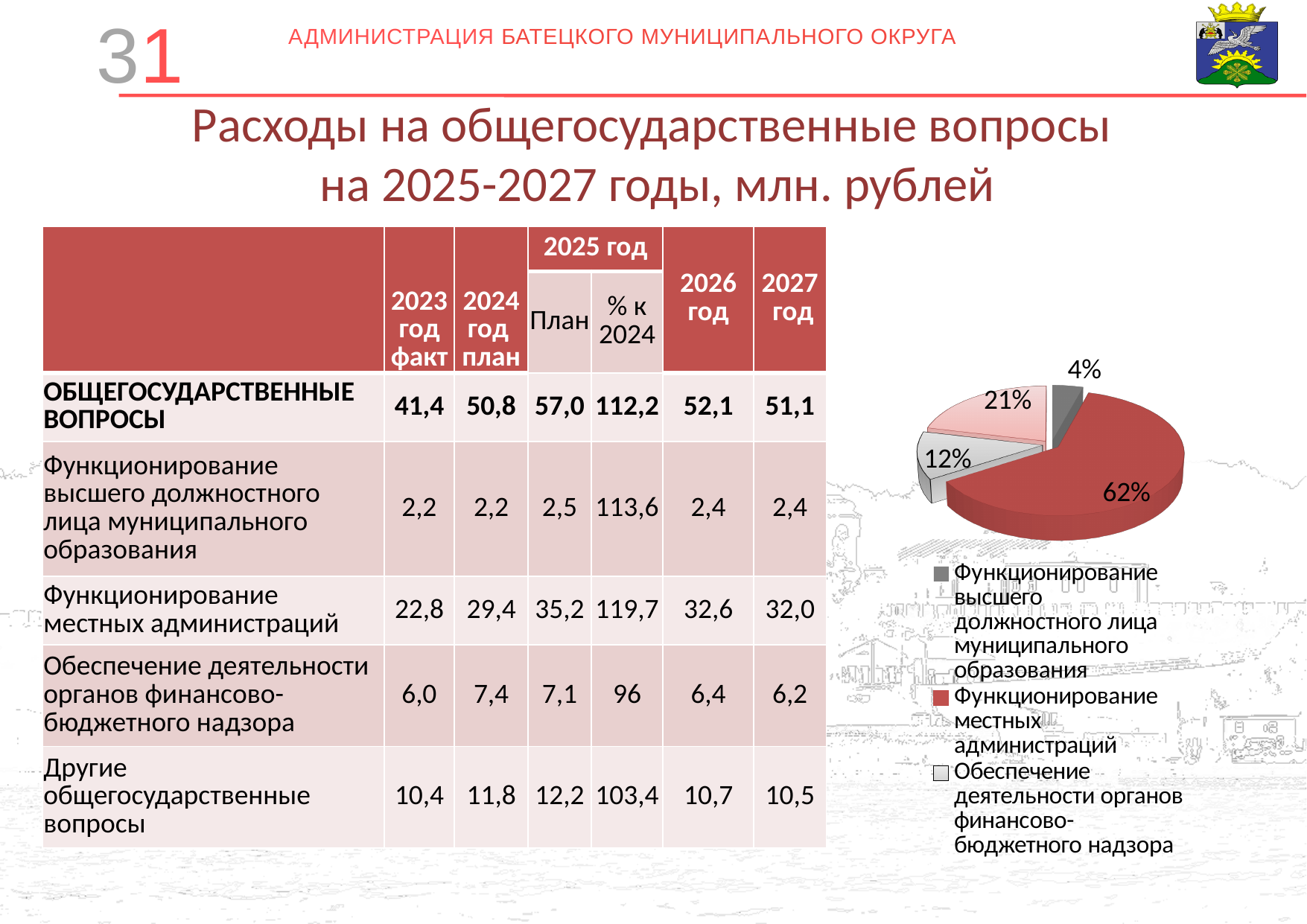
Which legend category has the smallest slice in the pie chart? Функционирование высшего должностного лица муниципального образования What colour is the slice for Функционирование местных администраций in the pie chart? red What kind of chart is shown on the right of the slide? pie chart Which legend category has the largest slice in the pie chart? Функционирование местных администраций What share of the pie chart is labelled for Функционирование высшего должностного лица муниципального образования? 4% What is the difference in percentage points between the 62% slice and the 12% slice in the pie chart? 50 How many entries are shown in the pie chart's legend? 3 How many slices does the pie chart have? 4 What share of the pie chart is labelled for Обеспечение деятельности органов финансово-бюджетного надзора? 12% What is the largest percentage label shown on the pie chart? 62% In the pie chart, which is larger: the slice for Функционирование местных администраций or the slice for Обеспечение деятельности органов финансово-бюджетного надзора? Функционирование местных администраций What share of the pie chart is labelled for Функционирование местных администраций? 62%